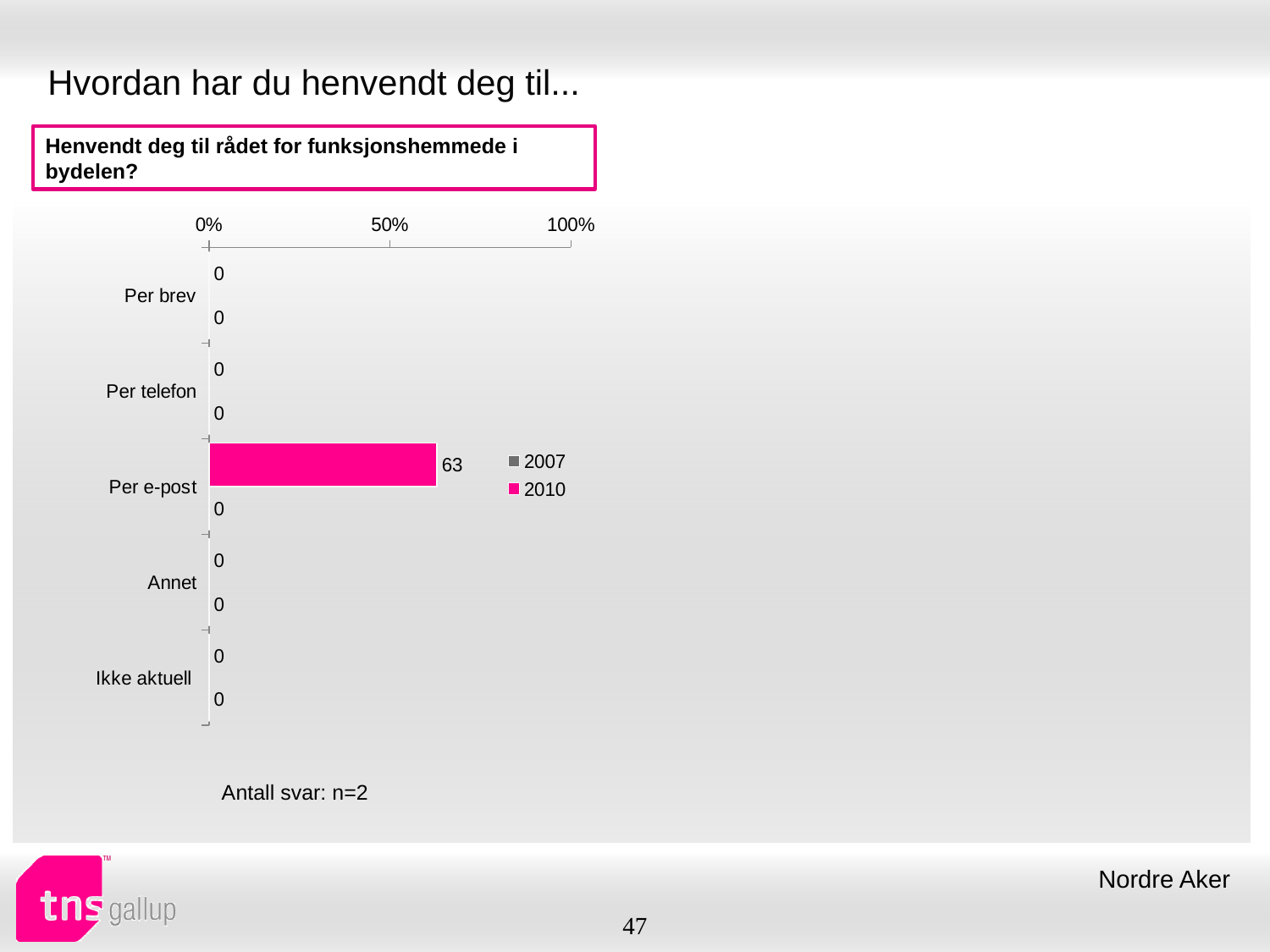
Is the 2010 value for Per e-post greater or less than 50%? greater What is the difference between the 2010 and 2007 values for Per e-post? 63 What is the value for Ikke aktuell in the 2010 series? 0 How many series does the legend list? 2 What is the value for Per e-post in the 2010 series? 63 Which series is shown in pink in the legend? 2010 What kind of chart is shown on the slide? Bar chart What is the value for Per brev in the 2010 series? 0 What is the value for Per telefon in the 2007 series? 0 How many categories are shown on the chart? 5 Which category has the highest value in the 2010 series? Per e-post Which is larger in the 2010 series: Per e-post or Annet? Per e-post